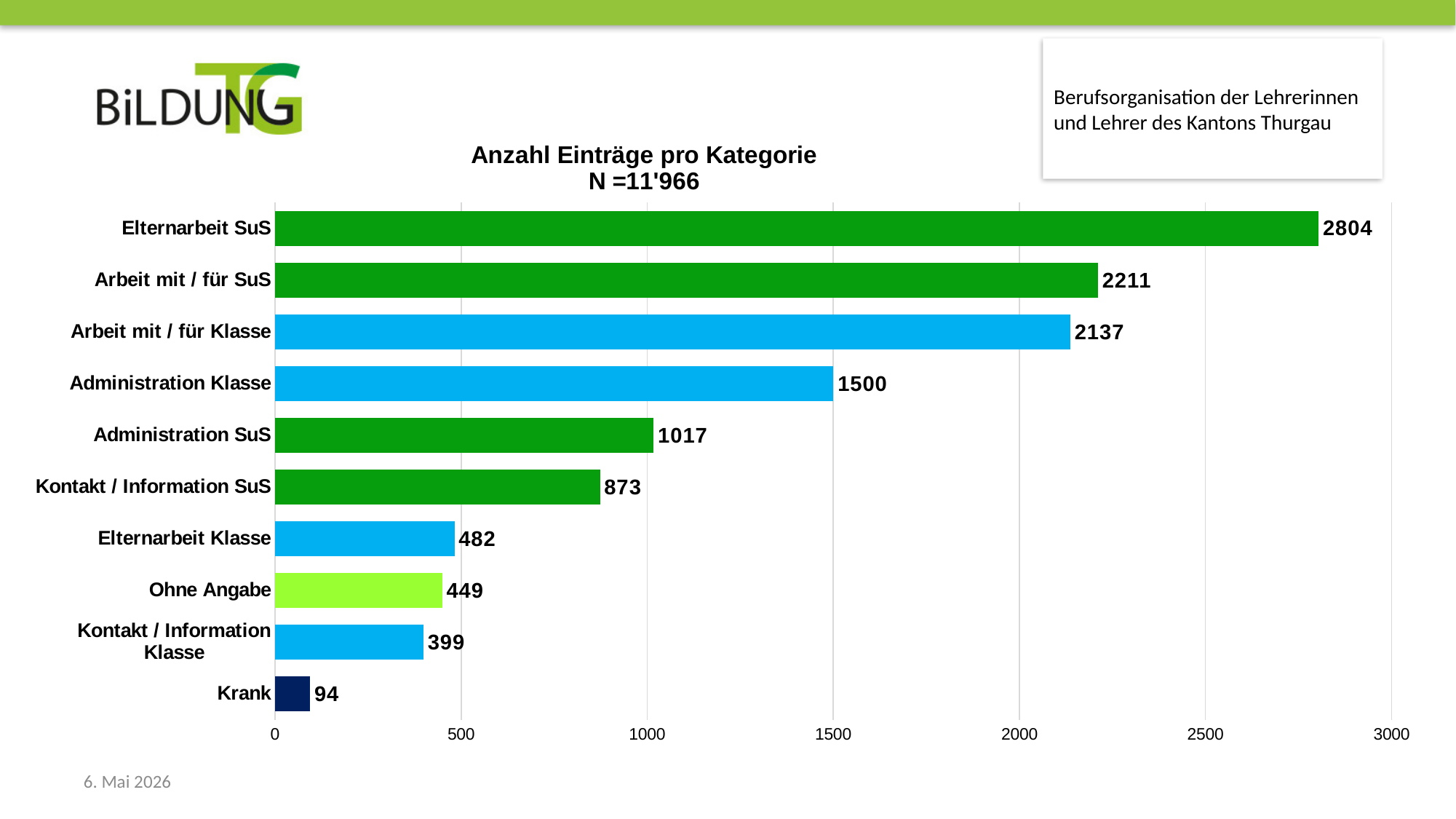
What is the value for Administration Klasse? 1500 Which category has the highest value? Elternarbeit SuS What is the value for Elternarbeit SuS? 2804 Which category has the lowest value? Krank Which is larger, Elternarbeit Klasse or Ohne Angabe? Elternarbeit Klasse What is the difference between Administration SuS and Kontakt / Information SuS? 144 What is the title of the chart? Anzahl Einträge pro Kategorie N =11'966 Is the value for Arbeit mit / für Klasse greater or less than 2000? greater What is the value for Kontakt / Information Klasse? 399 What kind of chart is shown on the slide? bar chart How many categories are shown in the chart? 10 What is the difference between Elternarbeit SuS and Arbeit mit / für SuS? 593